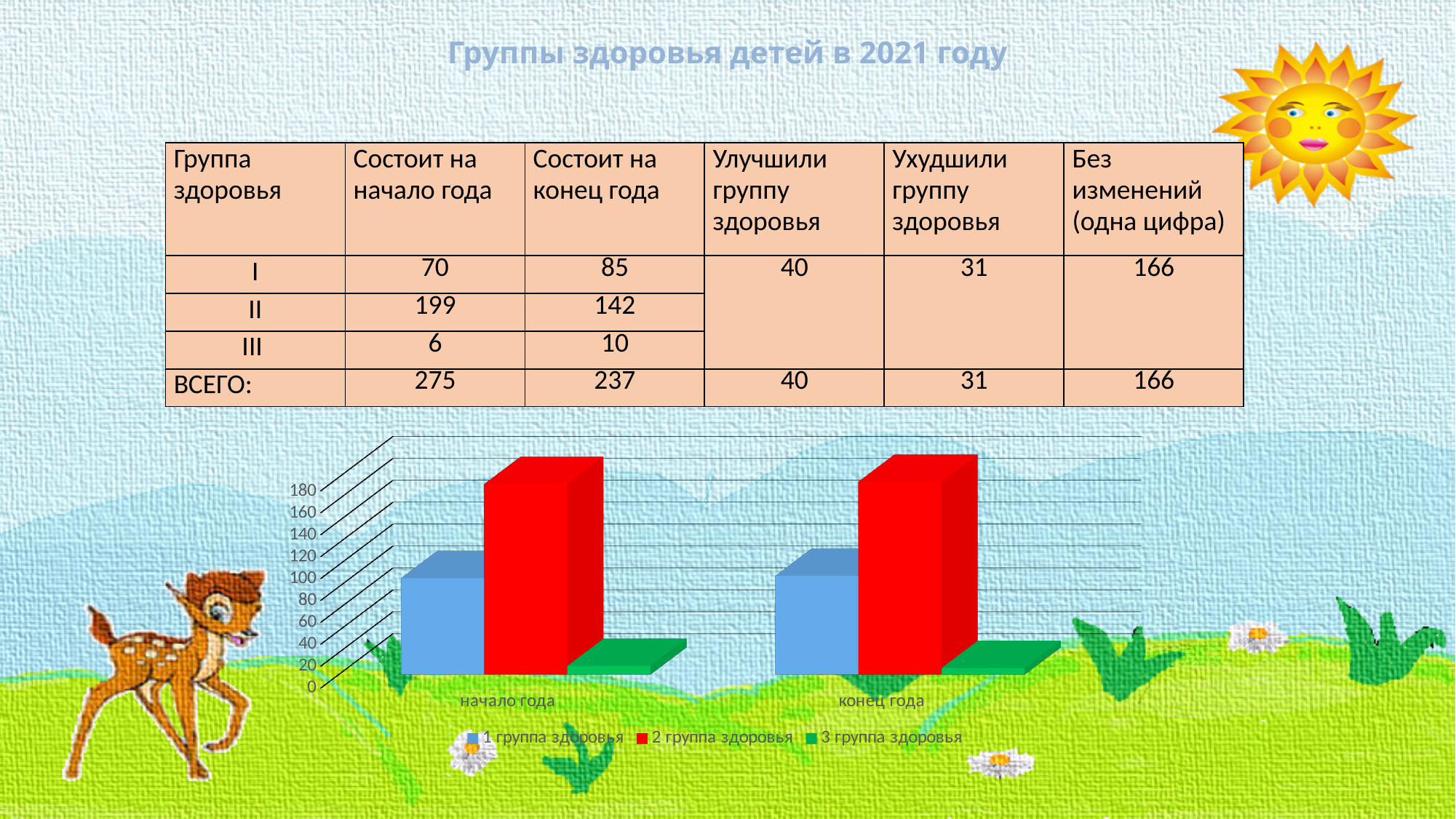
Which series has the lowest bar for начало года? 3 группа здоровья Is the value for 2 группа здоровья at начало года greater or less than 140? greater What are the two category labels on the x axis of the chart? начало года, конец года How many categories are shown on the x axis of the chart? 2 Is the value for 1 группа здоровья at начало года greater or less than 60? greater Which series has the highest bar for конец года? 2 группа здоровья What kind of chart is shown on the slide? bar chart Which series has the highest bar for начало года? 2 группа здоровья Is the value for 3 группа здоровья at конец года greater or less than 40? less How many series does the chart legend list? 3 For конец года, which is larger: the bar for 1 группа здоровья or the bar for 3 группа здоровья? 1 группа здоровья What colour are the bars for 2 группа здоровья in the chart? red